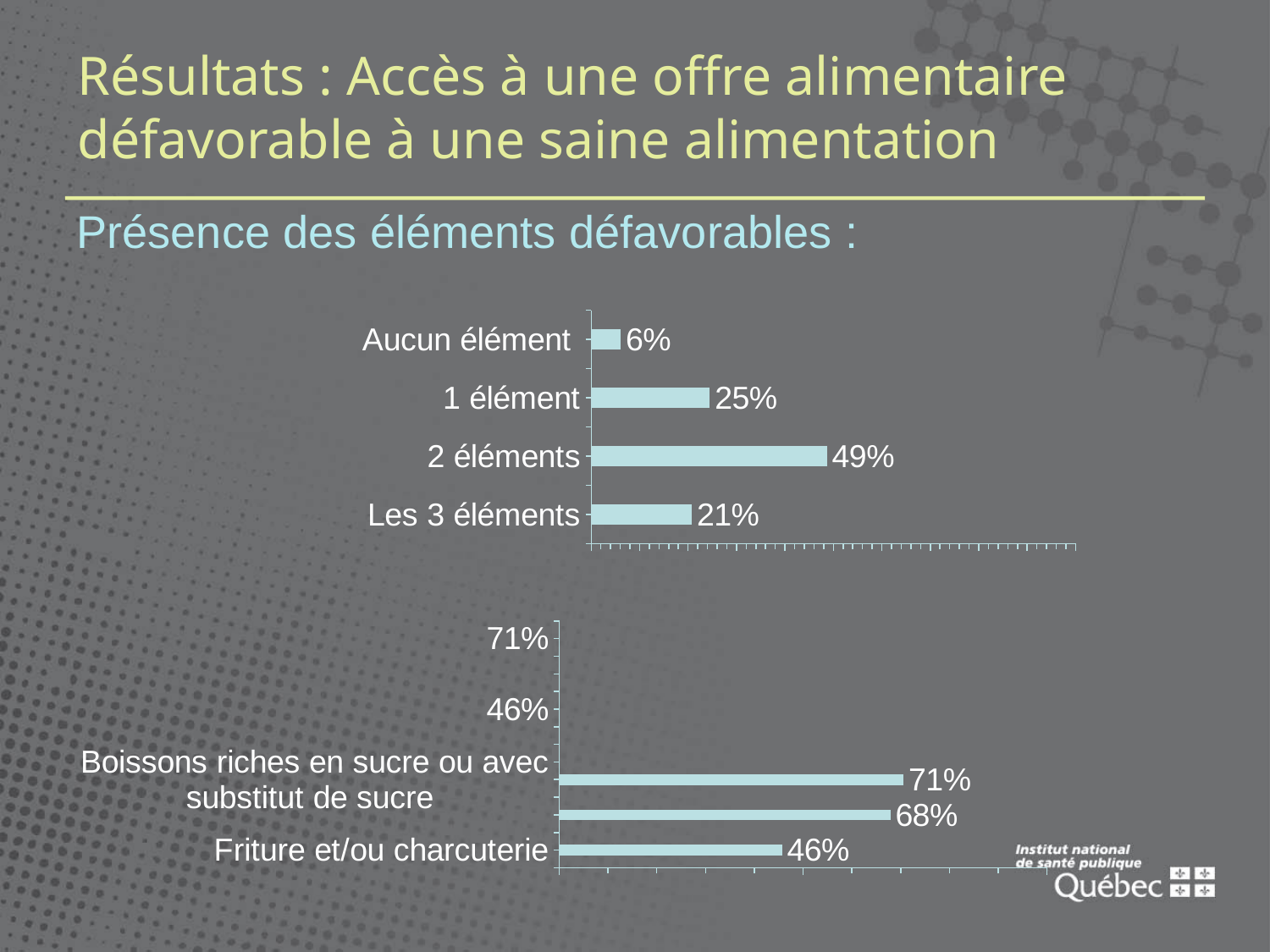
What kind of chart is the top chart? Bar chart In the top chart, which category has the lowest value? Aucun élément In the bottom chart, what is the value for 'Friture et/ou charcuterie'? 46% In the top chart, which category has the highest value? 2 éléments In the bottom chart, what is the difference between the values for 'Boissons riches en sucre ou avec substitut de sucre' and 'Friture et/ou charcuterie'? 25% In the top chart, which is larger: the value for '1 élément' or for 'Les 3 éléments'? 1 élément How many categories does the top chart show? 4 In the top chart, what is the value for '2 éléments'? 49% In the top chart, what is the value for 'Aucun élément'? 6% In the top chart, what is the difference between the values for '2 éléments' and '1 élément'? 24% In the top chart, what is the value for 'Les 3 éléments'? 21% In the bottom chart, what is the value for 'Boissons riches en sucre ou avec substitut de sucre'? 71%